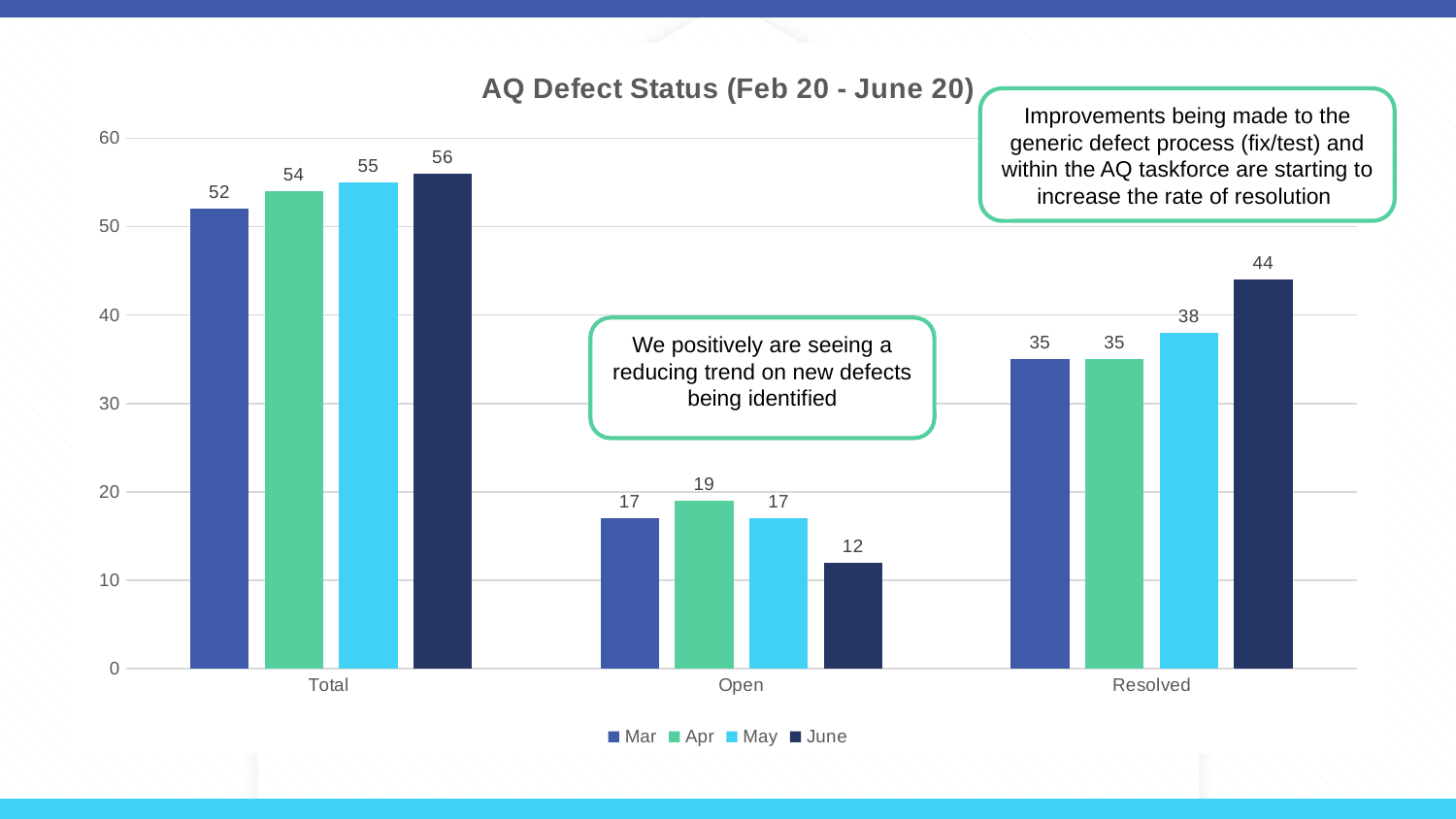
What is the value for Apr in the Open category? 19 Is the value for Mar in the Total category greater or less than 50? greater How many series does the legend list? 4 What is the value for June in the Total category? 56 What is the difference between the June and Mar values in the Resolved category? 9 Which month has the highest value in the Resolved category? June Which month has the lowest value in the Open category? June What is the title of the chart? AQ Defect Status (Feb 20 - June 20) What kind of chart is shown on the slide? bar chart Which is larger: the Apr value for Open or the June value for Open? Apr How many categories are shown on the x axis? 3 What is the value for May in the Resolved category? 38